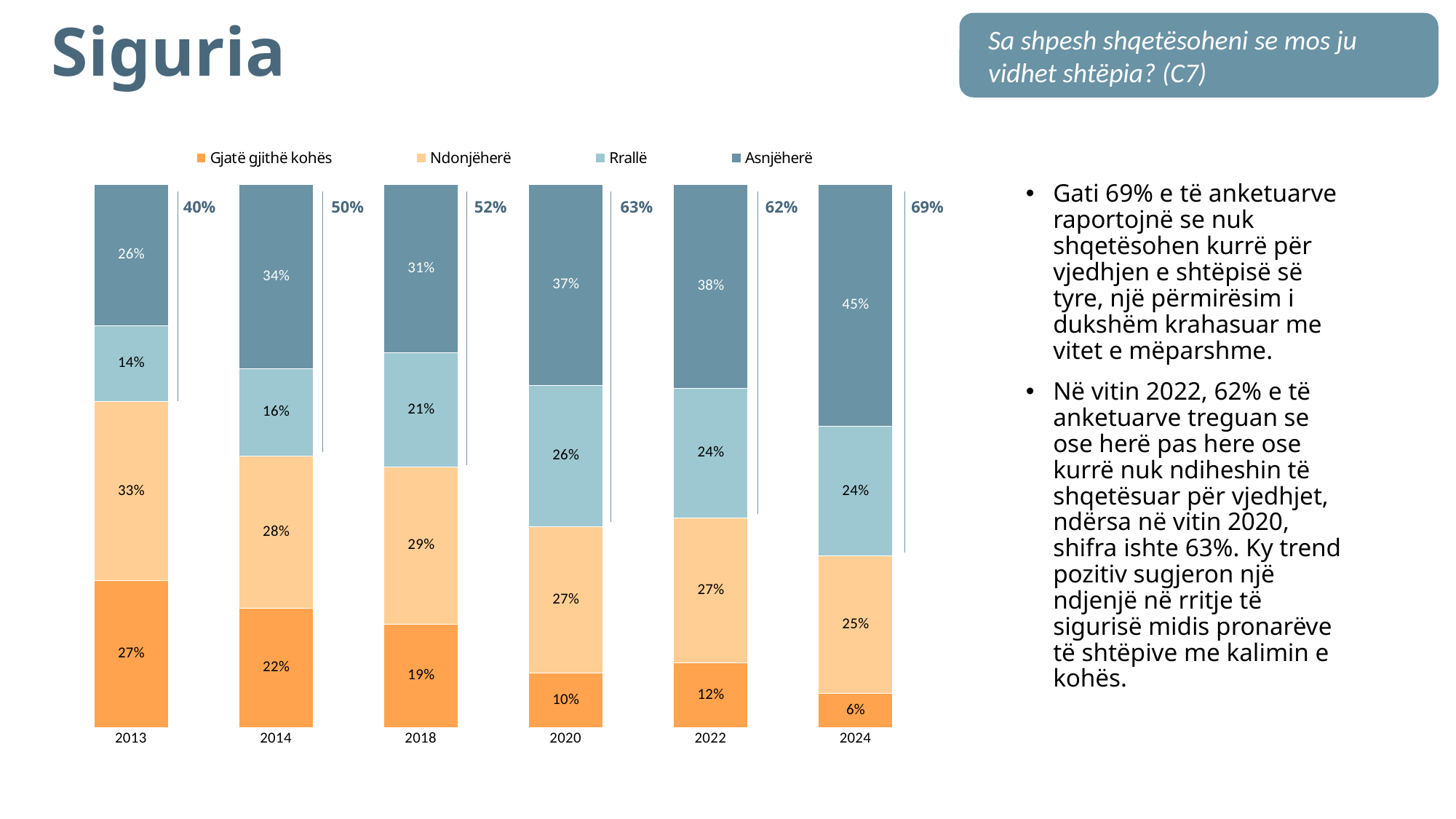
Which year has the highest value for "Asnjëherë"? 2024 What combined percentage is marked beside the 2020 bar? 63% How many years are shown on the x axis? 6 What is the value for "Rrallë" in 2018? 21% Does the value for "Gjatë gjithë kohës" rise or fall from 2013 to 2024? fall Which year has the lowest value for "Gjatë gjithë kohës"? 2024 What is the value for "Gjatë gjithë kohës" in 2013? 27% What kind of chart is shown on the slide? stacked bar chart What is the difference between the "Asnjëherë" values for 2024 and 2013? 19% Which is larger, the "Ndonjëherë" value in 2013 or in 2024? 2013 How many series does the legend list? 4 What is the value for "Asnjëherë" in 2024? 45%